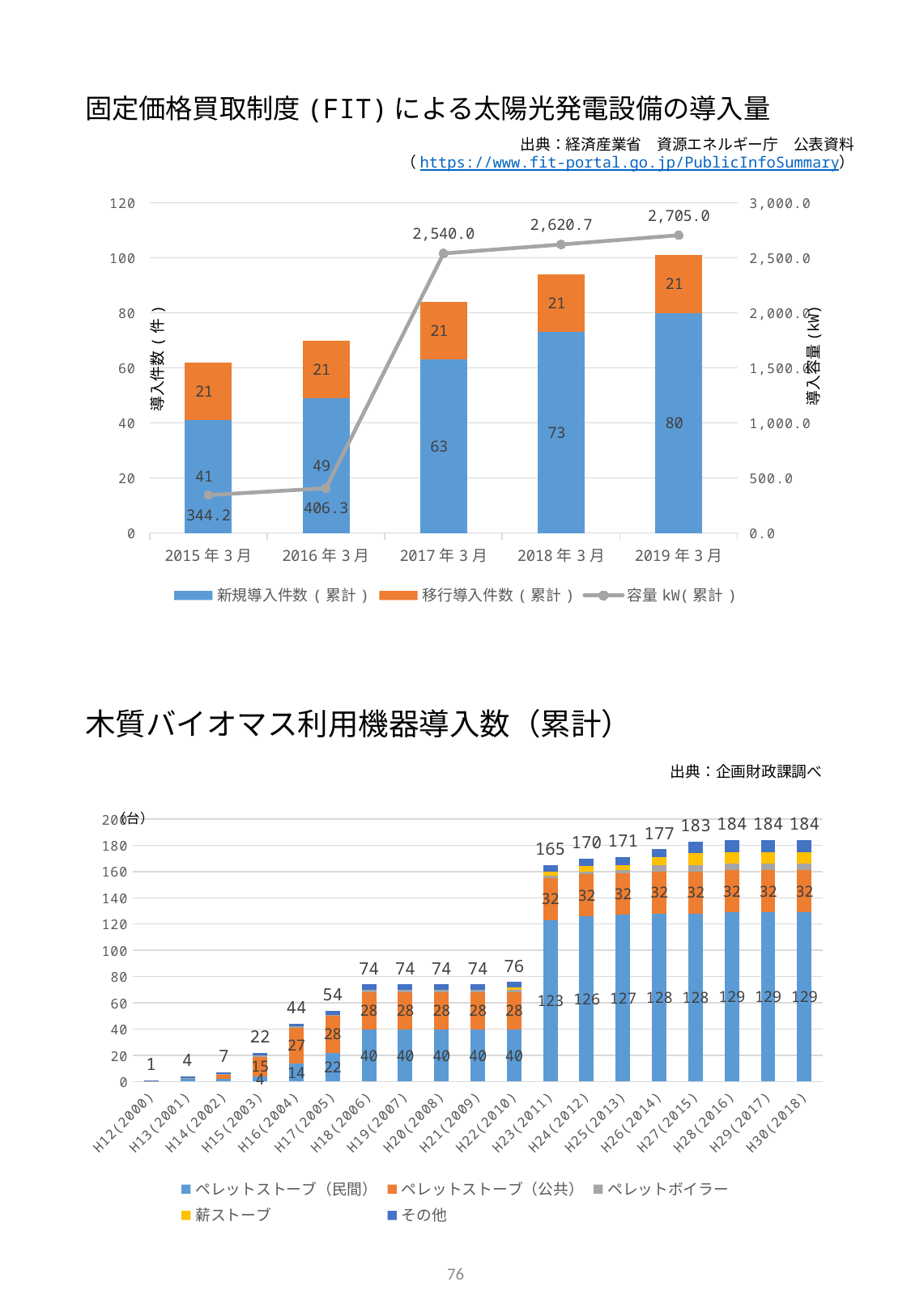
In the top chart, what is the 容量 kW(累計) value for 2015年3月? 344.2 In the top chart, what is the 容量 kW(累計) value for 2017年3月? 2,540.0 In the top chart, does the 容量 kW(累計) line rise or fall from 2015年3月 to 2019年3月? rise In the bottom chart, what is the difference between the totals for H23(2011) and H22(2010)? 89 In the top chart, how many series does the legend list? 3 In the bottom chart (木質バイオマス利用機器導入数(累計)), what is the total for H23(2011)? 165 In the bottom chart, which year has the lowest total? H12(2000) In the bottom chart, what is the value of ペレットストーブ(民間) for H30(2018)? 129 In the bottom chart, how many years are shown on the x axis? 19 In the top chart, what is the difference in 新規導入件数(累計) between 2019年3月 and 2015年3月? 39 In the top chart (固定価格買取制度(FIT)による太陽光発電設備の導入量), what is the value of 新規導入件数(累計) for 2019年3月? 80 In the top chart, what is the total of the stacked bar for 2018年3月? 94